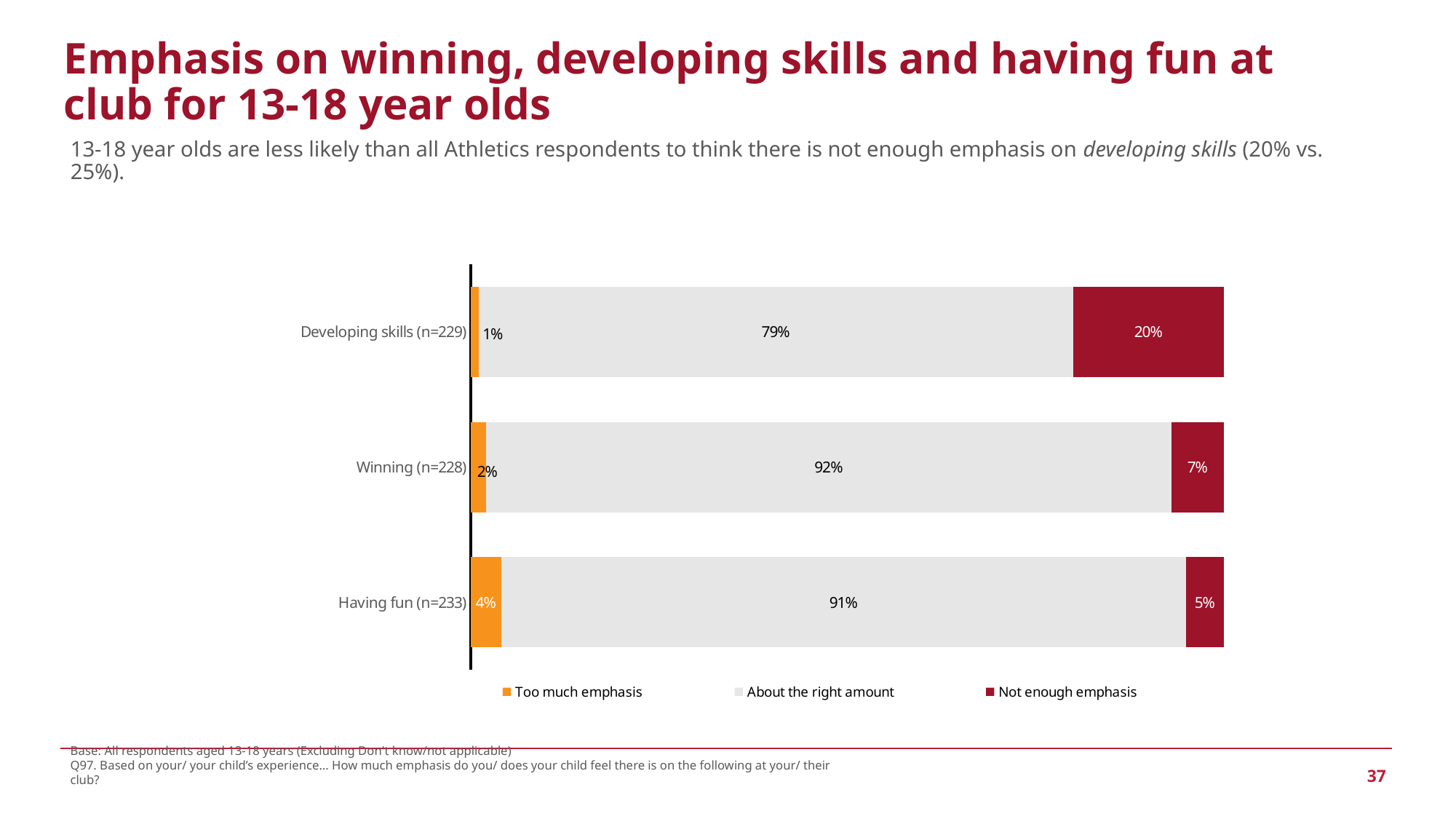
Which category has the lowest share saying 'Too much emphasis'? Developing skills (n=229) How many series does the legend list? 3 What is the total of the stacked bar for Having fun (n=233)? 100% What kind of chart is shown on the slide? Stacked bar chart How many categories are shown on the chart? 3 What percentage say there is too much emphasis on having fun? 4% Which category has the highest share saying 'Not enough emphasis'? Developing skills (n=229) Which is larger: the 'About the right amount' value for winning or for having fun? Winning (n=228) Which colour represents 'Not enough emphasis' in the legend? Dark red What is the difference between the 'Not enough emphasis' values for developing skills and winning? 13 percentage points What percentage of 13-18 year olds say there is not enough emphasis on developing skills? 20% What percentage say there is about the right amount of emphasis on winning? 92%